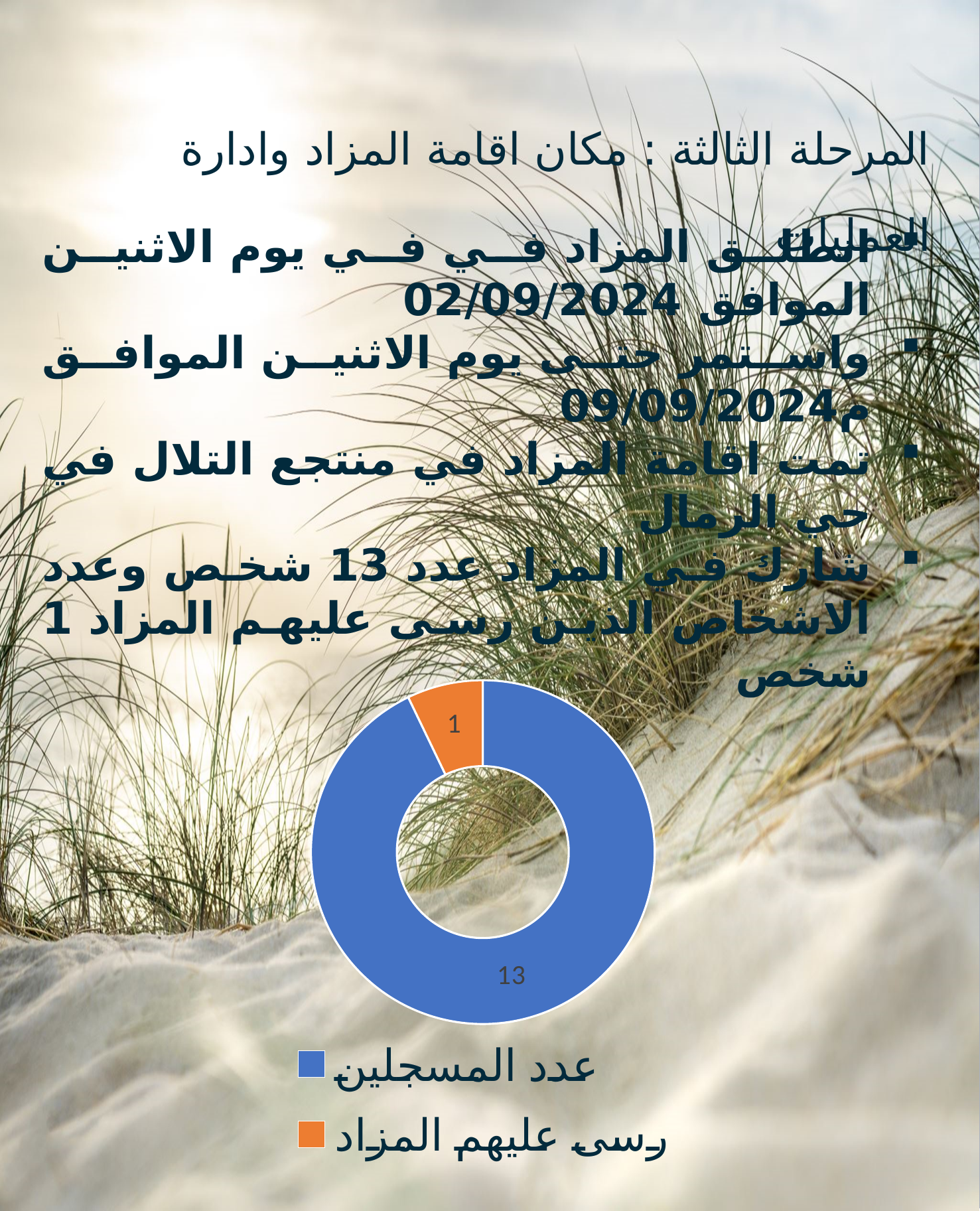
What is the difference between the value for عدد المسجلين and the value for رسى عليهم المزاد? 12 What colour is the slice for رسى عليهم المزاد? Orange Which category has the smallest slice in the chart? رسى عليهم المزاد How many slices does the chart have? 2 What colour is the slice for عدد المسجلين? Blue Which is larger, the value for عدد المسجلين or the value for رسى عليهم المزاد? عدد المسجلين What is the total of the two values shown in the chart? 14 What value is shown for عدد المسجلين in the doughnut chart? 13 What value is shown for رسى عليهم المزاد in the doughnut chart? 1 What kind of chart is shown on the slide? Doughnut chart How many entries does the chart legend list? 2 Which category has the largest slice in the chart? عدد المسجلين